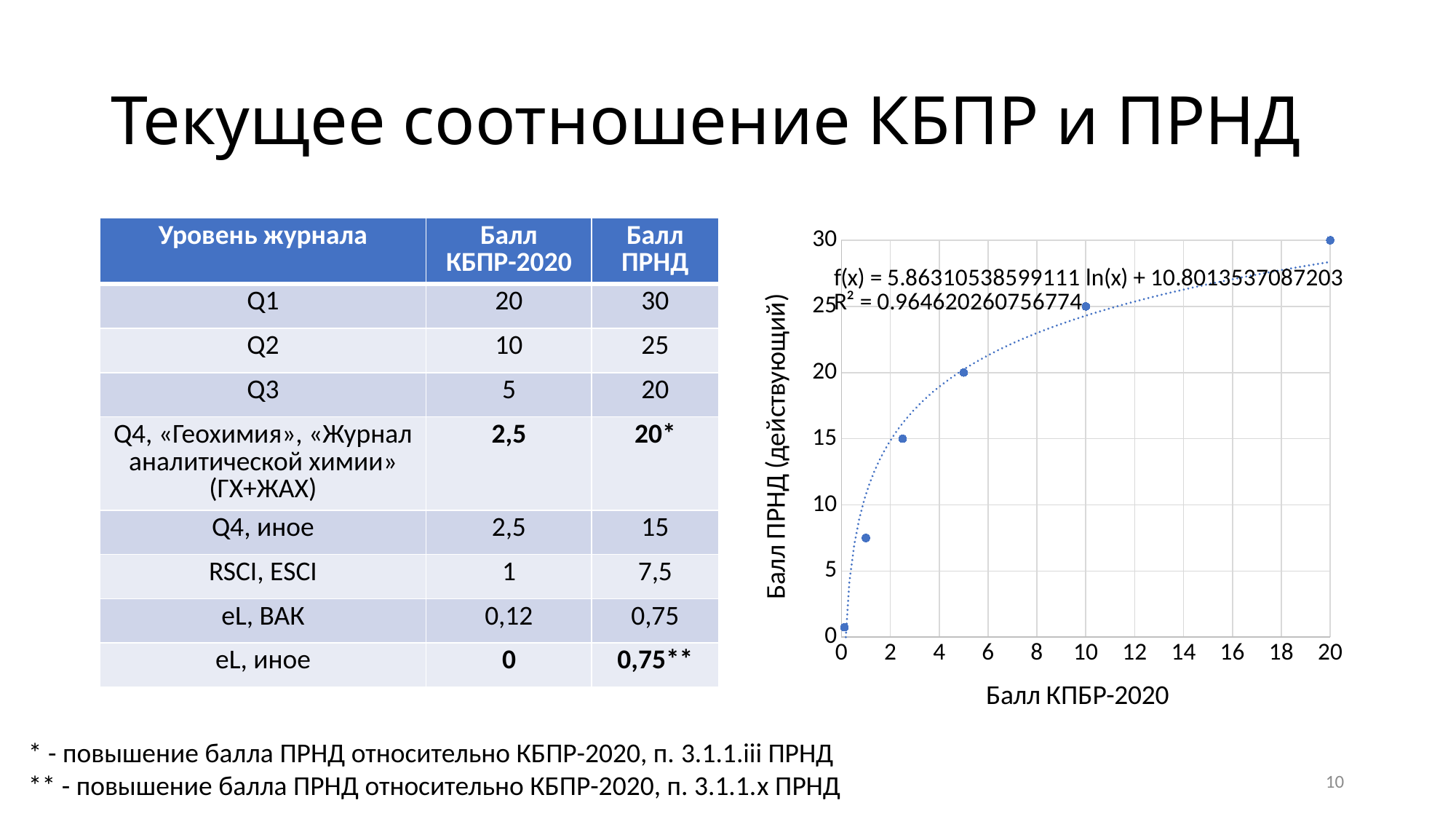
Is the Балл ПРНД value of the point at Балл КПБР-2020 = 1 greater or less than 10? less What is the difference in Балл ПРНД between the points at Балл КПБР-2020 = 20 and Балл КПБР-2020 = 10? 5 What is the Балл ПРНД value of the point at Балл КПБР-2020 = 10? 25 Do the plotted values rise or fall as Балл КПБР-2020 increases along the x axis? rise What kind of chart is shown on the slide? scatter chart How many data points are plotted in the chart? 6 What is the Балл ПРНД value of the point at Балл КПБР-2020 = 20? 30 Which point has the larger Балл ПРНД value: the one at Балл КПБР-2020 = 5 or the one at Балл КПБР-2020 = 2.5? the one at 5 What is the R² value printed on the chart for the trendline? 0.964620260756774 What is the Балл ПРНД value of the point at Балл КПБР-2020 = 5? 20 Is the Балл ПРНД value of the point at Балл КПБР-2020 = 2.5 greater or less than 10? greater At which Балл КПБР-2020 value is the plotted Балл ПРНД highest? 20